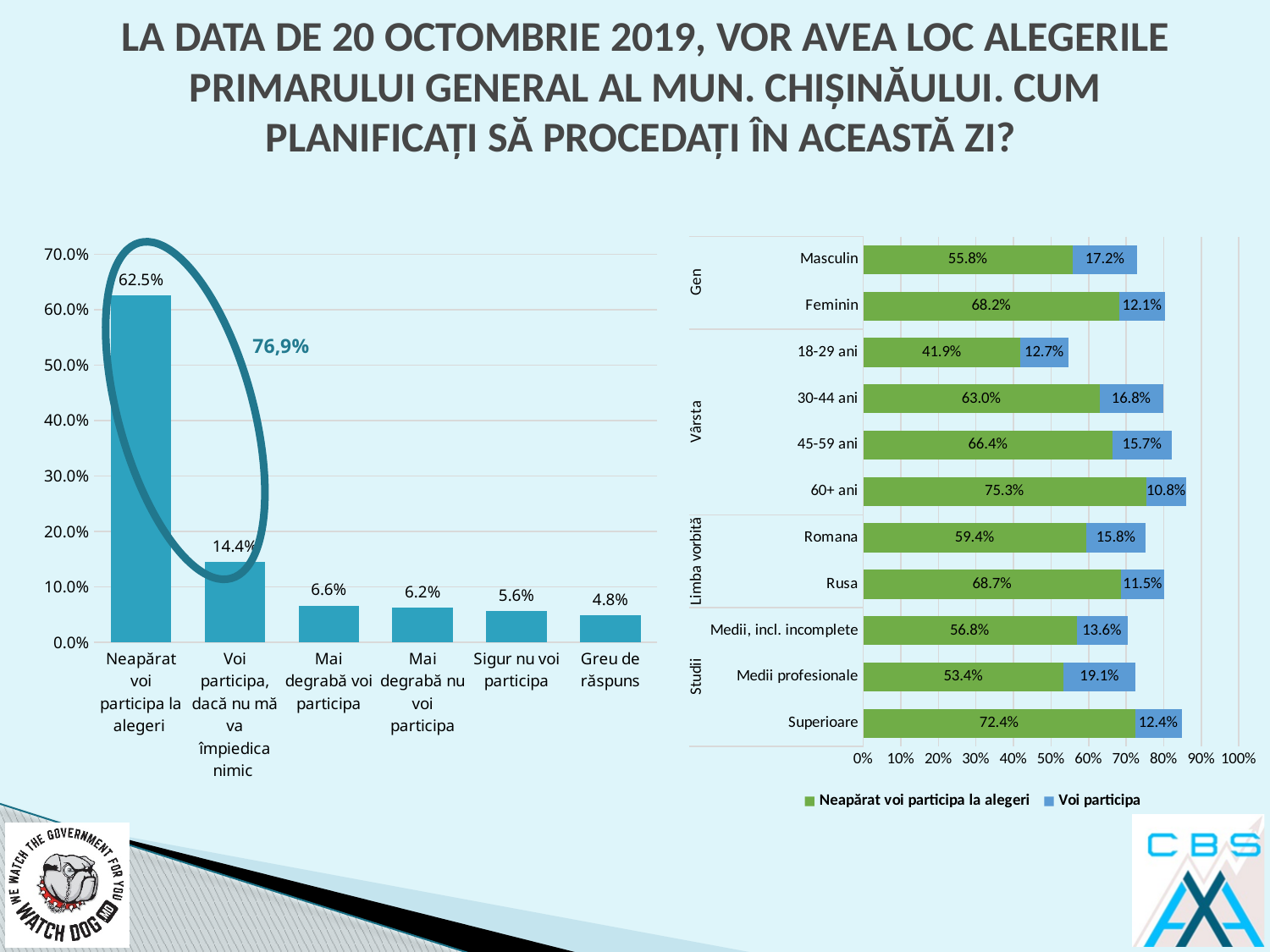
How many series does the legend of the right chart list? 2 In the left chart, do the values rise or fall from left to right along the x axis? fall In the right chart, what is the value of "Voi participa" for "Medii profesionale"? 19.1% In the right chart, which category has the highest value for "Neapărat voi participa la alegeri"? 60+ ani In the left chart, which category has the lowest value? Greu de răspuns What kind of chart is the left chart? bar chart In the right chart, what is the total of the stacked bar for "Feminin"? 80.3% In the left chart, what is the difference between "Neapărat voi participa la alegeri" and "Voi participa, dacă nu mă va împiedica nimic"? 48.1% In the right chart, which is larger for "Neapărat voi participa la alegeri": "Masculin" or "Feminin"? Feminin In the right chart, what is the value of "Neapărat voi participa la alegeri" for "60+ ani"? 75.3% How many categories are shown on the x axis of the left chart? 6 In the left chart, what is the value for "Neapărat voi participa la alegeri"? 62.5%